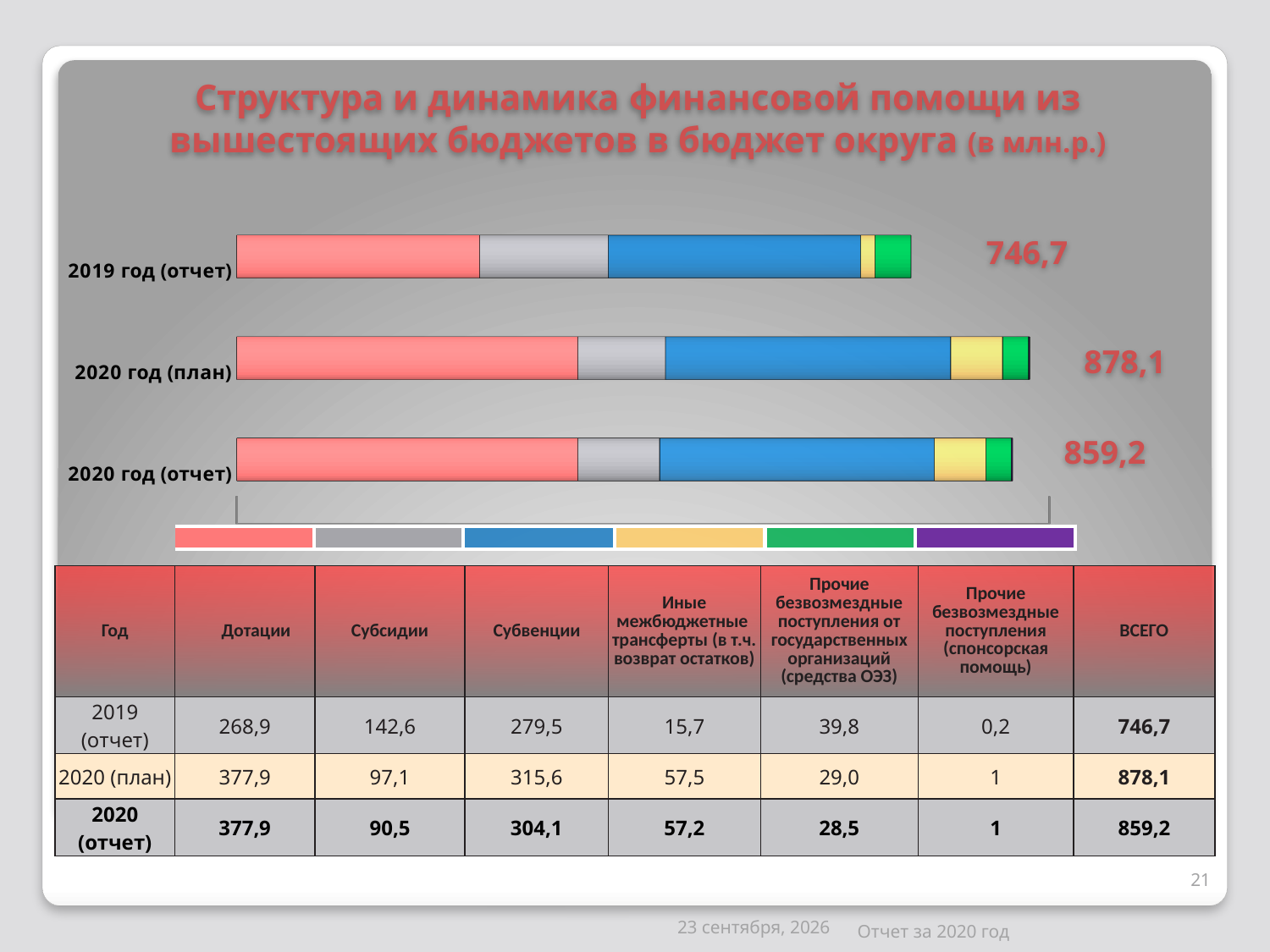
Which category has the lowest total value in the bar chart? 2019 год (отчет) According to the table under the chart, what is the value of Дотации for 2020 (отчет)? 377,9 Which category has the highest total value in the bar chart? 2020 год (план) How many categories (years) are plotted in the bar chart? 3 What is the total value shown next to the bar for 2019 год (отчет)? 746,7 Which is larger, the total for 2020 год (план) or the total for 2020 год (отчет)? 2020 год (план) What is the total value shown next to the bar for 2020 год (план)? 878,1 What kind of chart is shown on the slide? Stacked bar chart What is the difference between the totals for 2020 год (план) and 2020 год (отчет)? 18,9 What is the difference between the totals for 2020 год (отчет) and 2019 год (отчет)? 112,5 What is the title of the chart on the slide? Структура и динамика финансовой помощи из вышестоящих бюджетов в бюджет округа (в млн.р.) How many series (colour swatches) does the chart legend show? 6